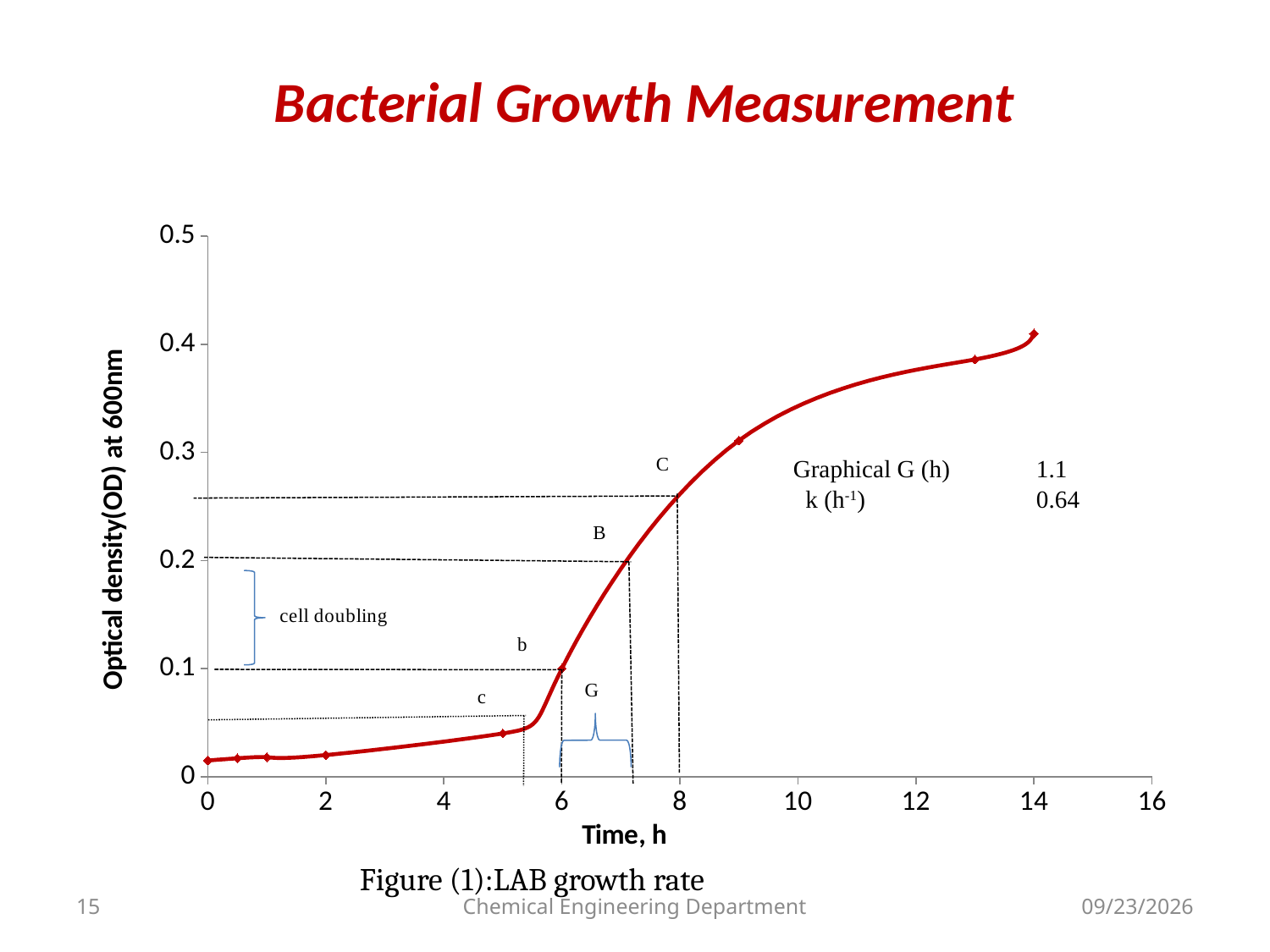
What is the optical density at 6 h, where the dashed line meets the curve? 0.1 Is the optical density at 5 h greater or less than 0.1? less What value is given for k (h-1) on the chart? 0.64 Is the optical density at 13 h greater or less than 0.4? less What value is given for Graphical G (h) on the chart? 1.1 Is the optical density at 14 h greater or less than 0.4? greater What kind of chart is shown on the slide? line chart What is the title of the x axis? Time, h At which time is the optical density highest? 14 h What is the figure caption below the chart? Figure (1):LAB growth rate Does the optical density rise or fall as time increases? rises